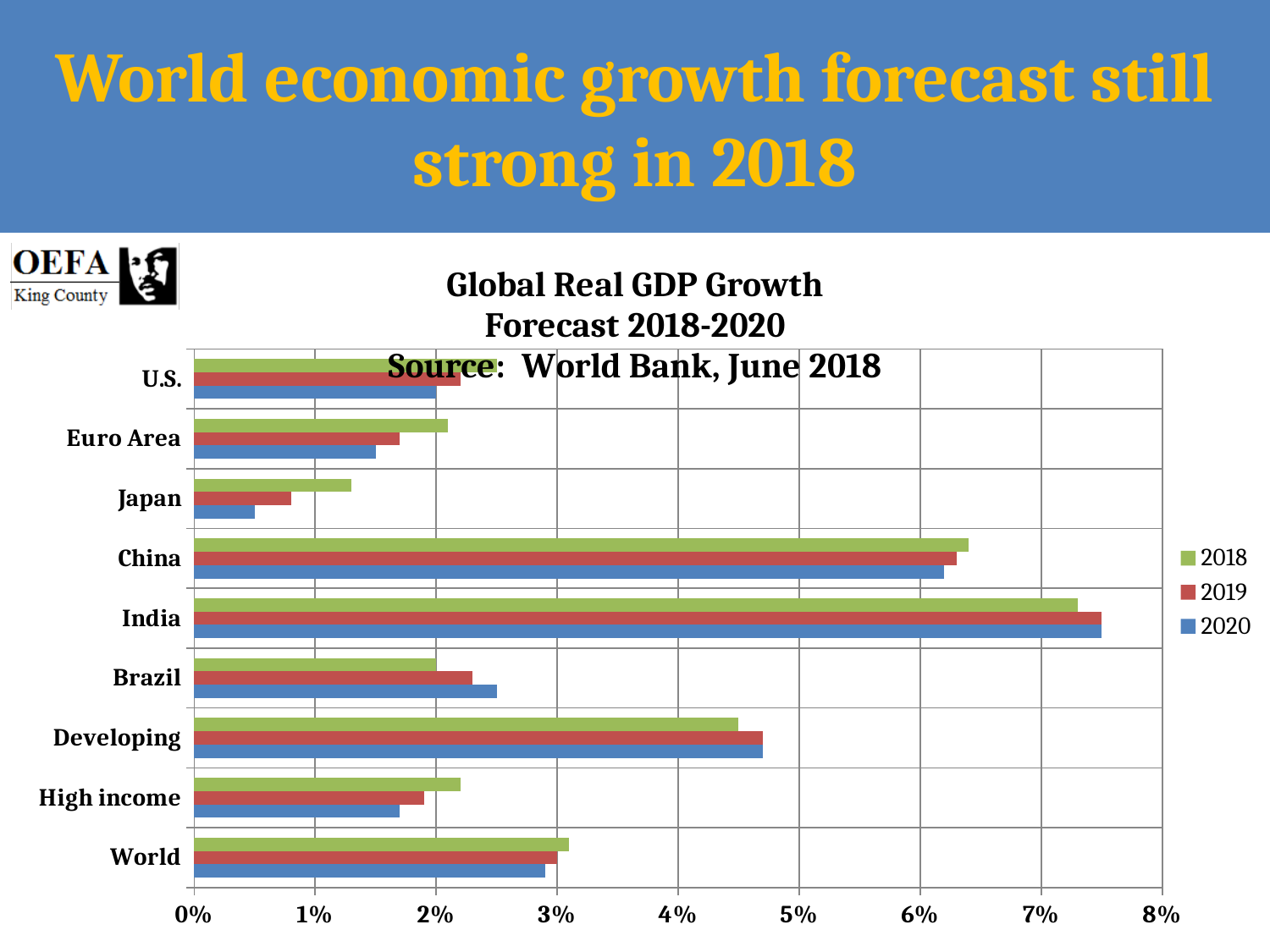
How many series does the legend list? 3 Is the 2019 value for Developing greater or less than 4%? greater Which category has the highest 2018 forecast? India Is the 2020 value for Japan greater or less than 1%? less What is the title of the chart? Global Real GDP Growth Forecast 2018-2020 Do Japan's forecast values rise or fall from 2018 to 2020? fall How many categories (economies/regions) are shown on the chart? 9 For Brazil, which is larger, the 2018 forecast or the 2020 forecast? 2020 Which category has the lowest 2020 forecast? Japan Which is larger, the 2018 forecast for India or the 2018 forecast for China? India What kind of chart is shown on the slide? bar chart Is the 2018 value for China greater or less than 6%? greater